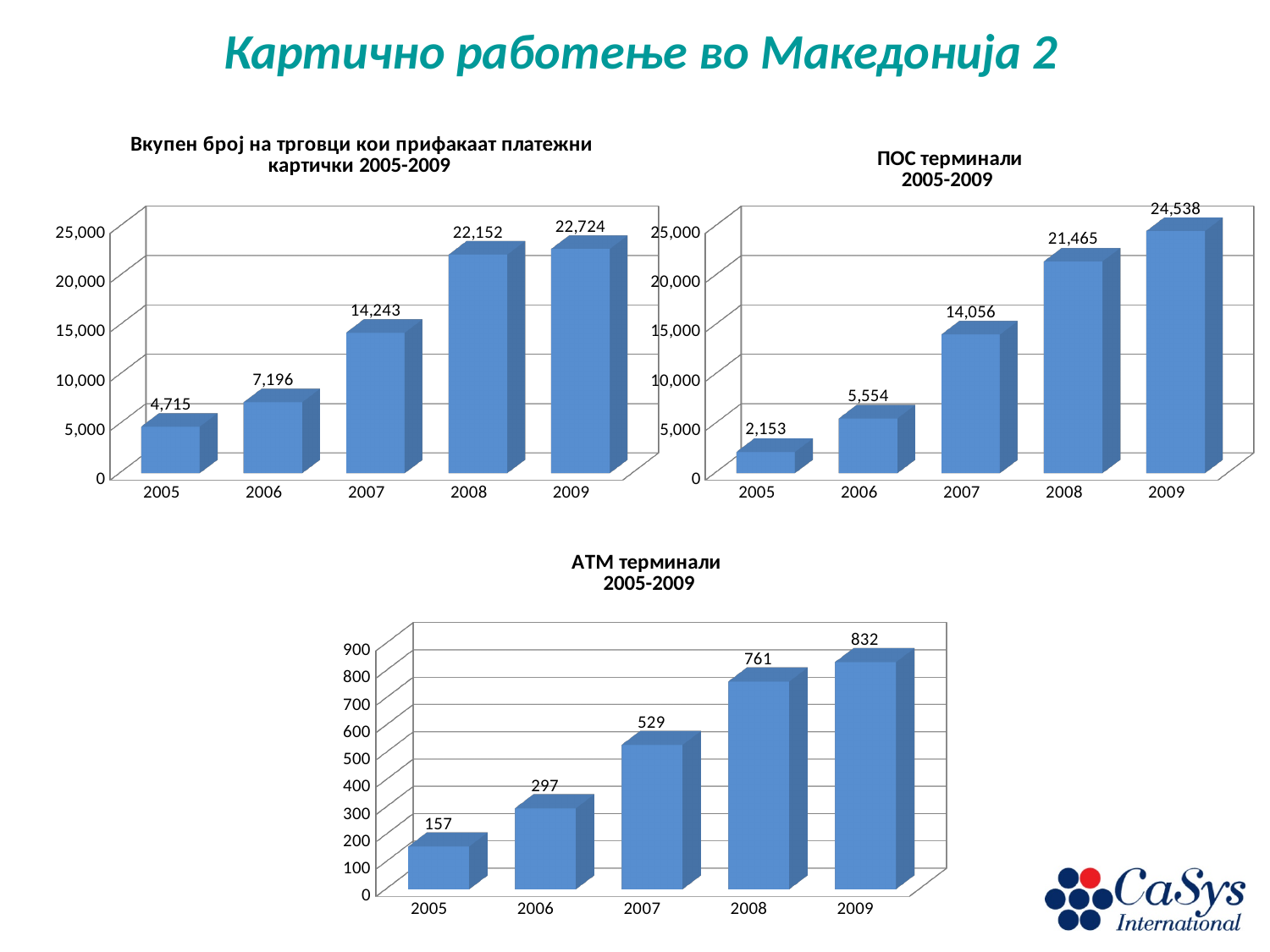
In the bottom chart (АТМ терминали 2005-2009), what is the value for 2008? 761 In the top-right chart (ПОС терминали 2005-2009), what is the value for 2006? 5,554 In the bottom chart (АТМ терминали), what is the difference between the 2007 and 2006 values? 232 In the top-left chart (Вкупен број на трговци), which year has the highest value? 2009 In the top-right chart (ПОС терминали), which year has the lowest value? 2005 What kind of chart is the bottom chart (АТМ терминали)? bar chart In the bottom chart (АТМ терминали), which is larger, the value for 2006 or the value for 2007? 2007 In the bottom chart (АТМ терминали), do the values rise or fall from 2005 to 2009? rise In the top-left chart (Вкупен број на трговци), what is the difference between the 2009 and 2008 values? 572 How many years are shown on the x axis of the top-right chart (ПОС терминали)? 5 In the top-left chart (Вкупен број на трговци кои прифакаат платежни картички 2005-2009), what is the value for 2007? 14,243 In the top-right chart (ПОС терминали), what is the difference between the 2009 and 2008 values? 3,073